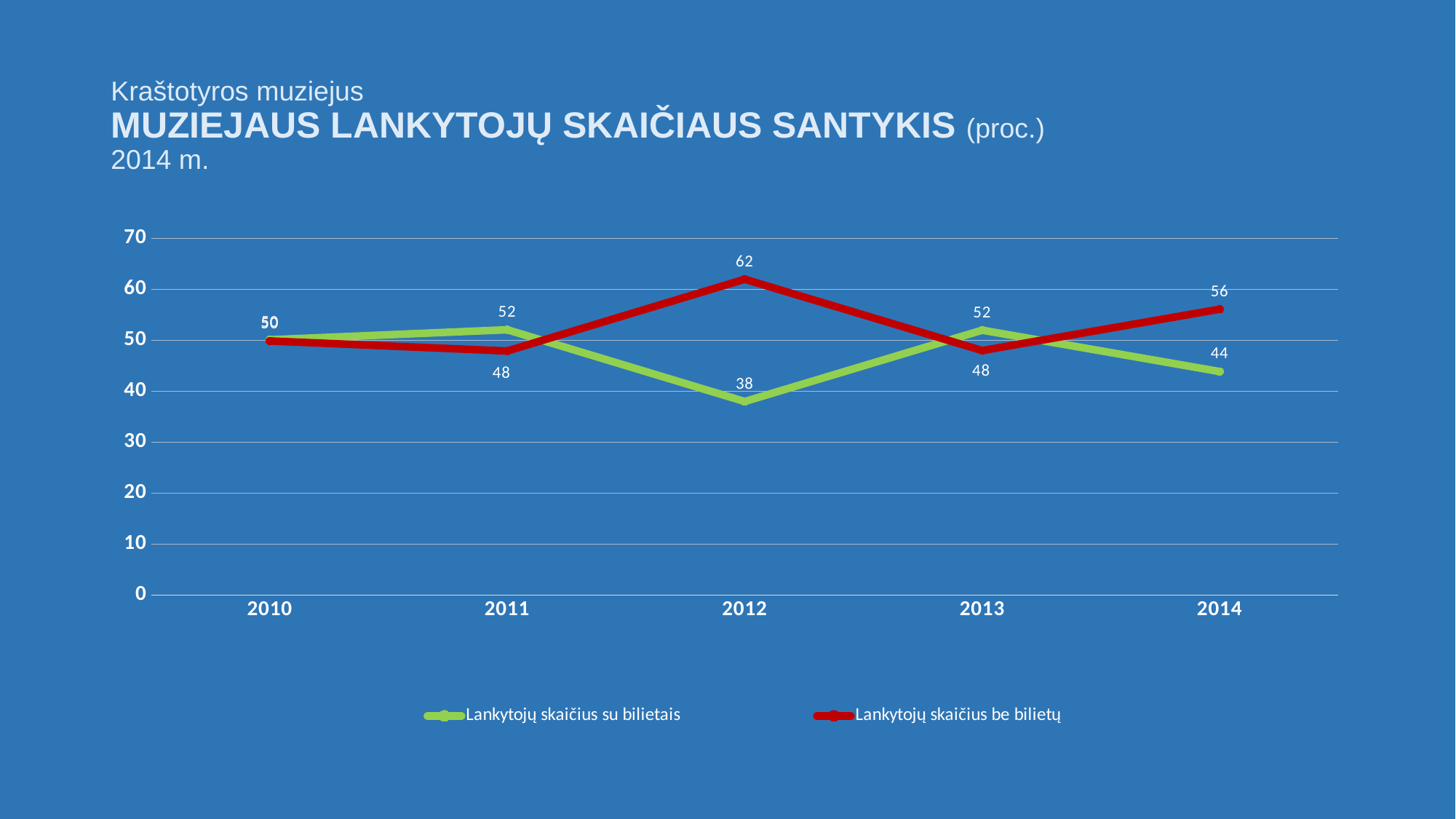
What kind of chart is shown on the slide? line chart In which year is 'Lankytojų skaičius su bilietais' lowest? 2012 How many series does the legend list? 2 What is the difference between 'Lankytojų skaičius be bilietų' and 'Lankytojų skaičius su bilietais' in 2012? 24 What is the value for 'Lankytojų skaičius su bilietais' in 2014? 44 In 2013, which series has the larger value, 'Lankytojų skaičius su bilietais' or 'Lankytojų skaičius be bilietų'? Lankytojų skaičius su bilietais In which year is 'Lankytojų skaičius be bilietų' highest? 2012 Which colour is used for the 'Lankytojų skaičius be bilietų' line? red What is the value for 'Lankytojų skaičius be bilietų' in 2014? 56 Does 'Lankytojų skaičius su bilietais' rise or fall from 2013 to 2014? fall What is the value for 'Lankytojų skaičius su bilietais' in 2012? 38 How many years are plotted along the x axis? 5